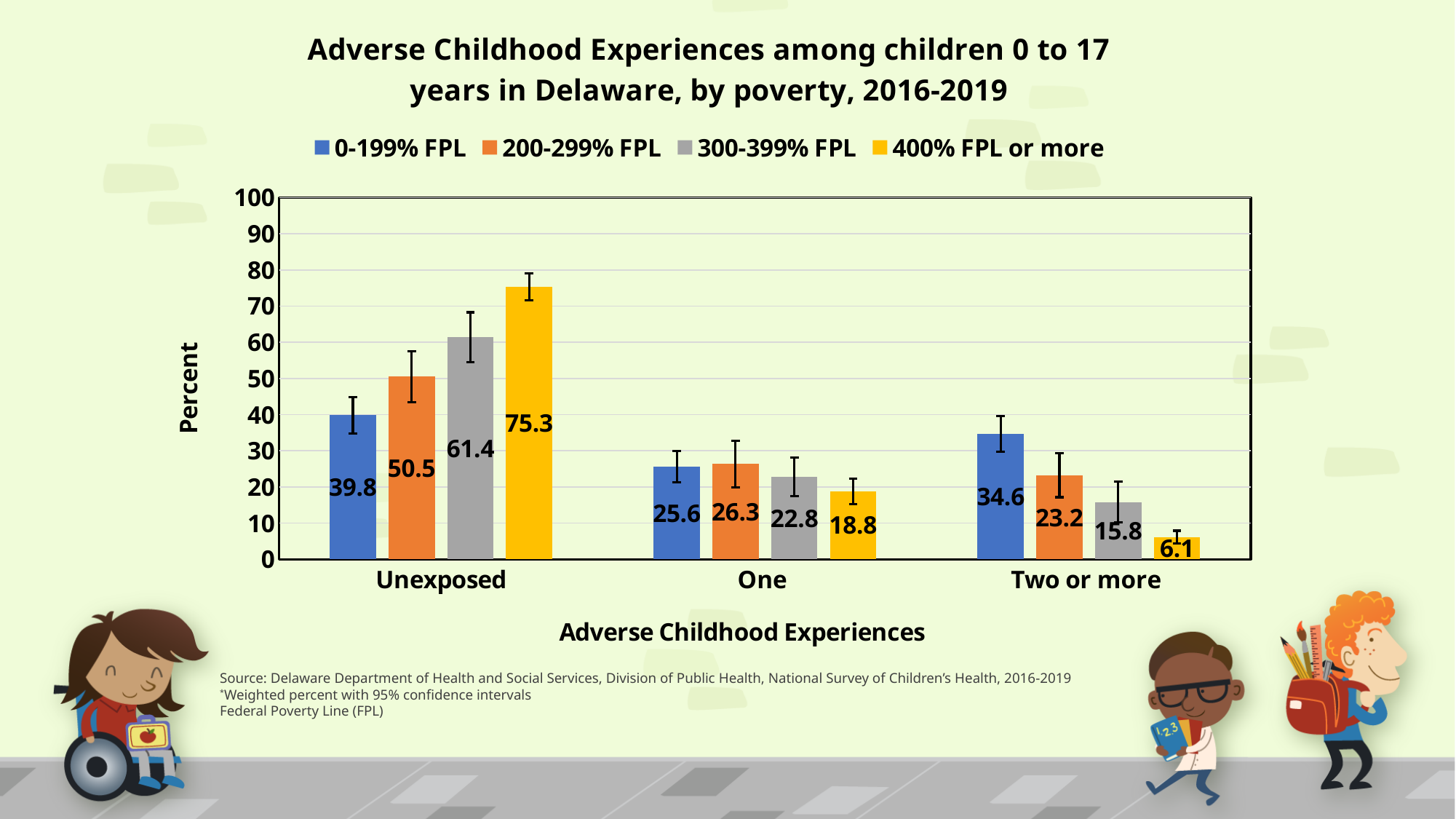
What is the difference between the 400% FPL or more and 0-199% FPL values in the Unexposed category? 35.5 Which poverty group has the lowest value in the Two or more category? 400% FPL or more How many series does the legend list? 4 What is the value for 0-199% FPL in the Two or more category? 34.6 How many categories are shown on the x axis? 3 What is the difference between the 0-199% FPL and 400% FPL or more values in the Two or more category? 28.5 Which poverty group has the highest value in the Unexposed category? 400% FPL or more How do the values for 400% FPL or more change from Unexposed to Two or more? They fall What is the value for 300-399% FPL in the One category? 22.8 What kind of chart is shown on the slide? Bar chart Which is larger in the One category: the value for 0-199% FPL or the value for 400% FPL or more? 0-199% FPL What is the value for 400% FPL or more in the Unexposed category? 75.3